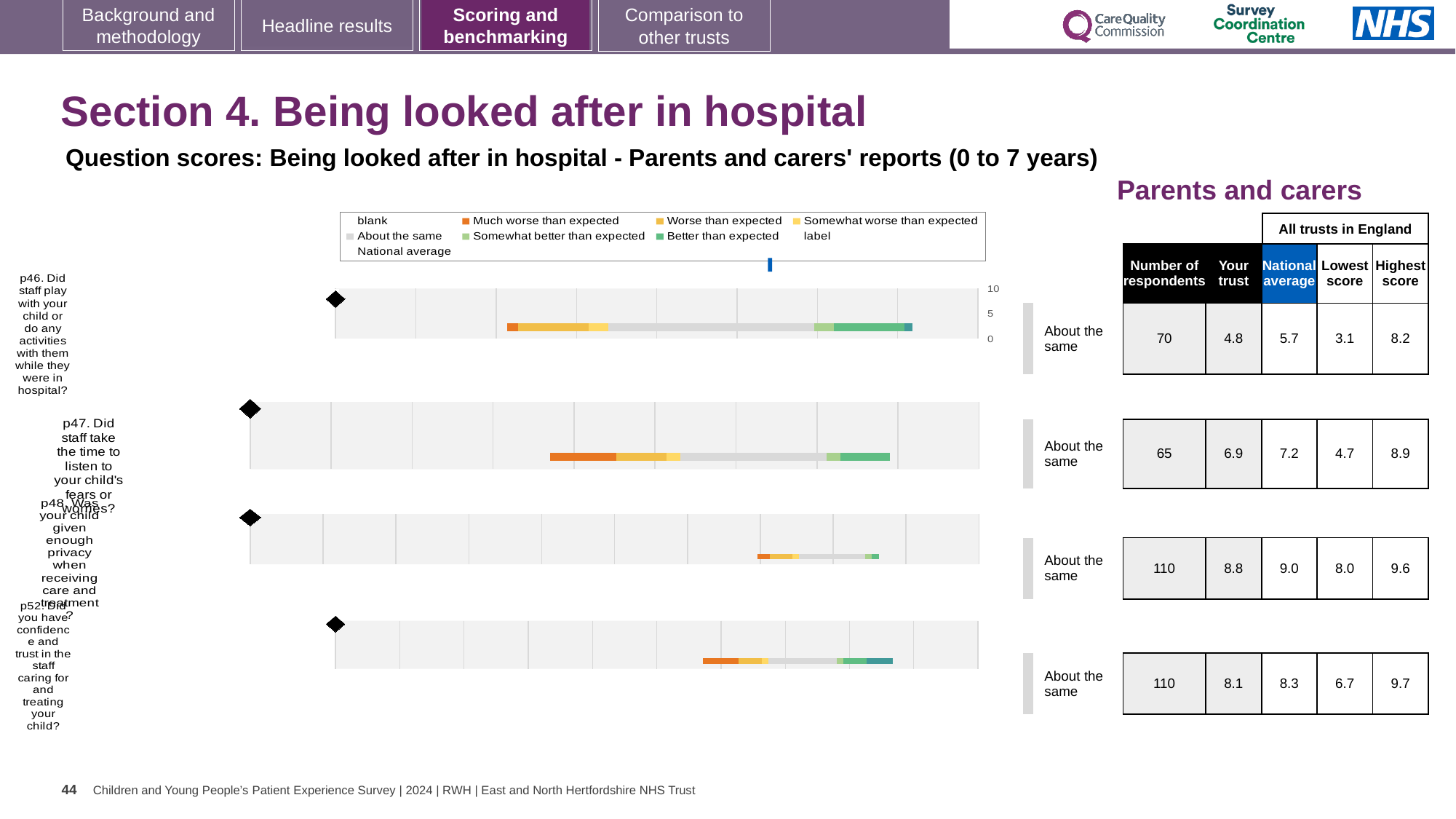
Which question has the highest 'Your trust' score? p48 What benchmark category is shown next to each of the four question bars? About the same For p47, what is the difference between the national average and the 'Your trust' score? 0.3 What is the 'Your trust' score for p46 (Did staff play with your child or do any activities with them while they were in hospital?)? 4.8 What is the highest score across all trusts in England for p48 (Was your child given enough privacy when receiving care and treatment?)? 9.6 What is the national average score for p47 (Did staff take the time to listen to your child's fears or worries?)? 7.2 How many survey questions (bars) are shown in the chart area? 4 Is the 'Your trust' score for p46 greater or less than 5? less What kind of chart is used to show the question scores on this slide? Bar chart Which question has the lowest 'Your trust' score? p46 For p52, which is larger: the 'Your trust' score or the national average? National average How many respondents answered p52 (Did you have confidence and trust in the staff caring for and treating your child?)? 110